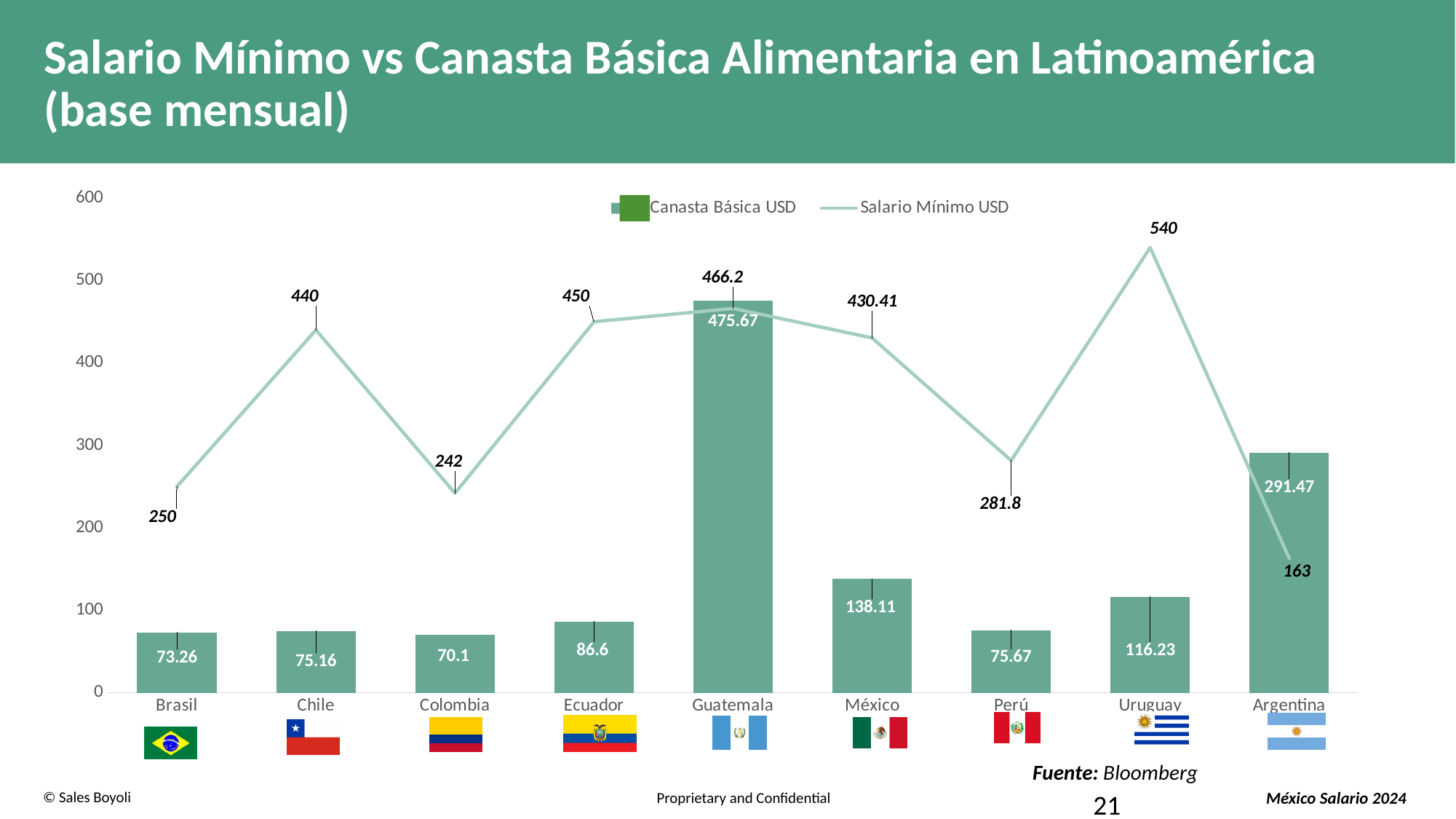
Which country has the highest Canasta Básica USD value? Guatemala Which country has the lowest Canasta Básica USD value? Colombia What kind of chart is shown on the slide? A bar chart combined with a line chart For Argentina, how much larger is the Canasta Básica USD value than the Salario Mínimo USD value? 128.47 For Guatemala, which is larger: the Canasta Básica USD value or the Salario Mínimo USD value? Canasta Básica USD What is the Salario Mínimo USD value for Perú? 281.8 What is the Salario Mínimo USD value for Uruguay? 540 Which country has the lowest Salario Mínimo USD value? Argentina What is the Canasta Básica USD value for México? 138.11 How many countries are shown on the x axis of the chart? 9 How many series does the chart legend list? 2 What is the difference between the Salario Mínimo USD values for Chile and Colombia? 198